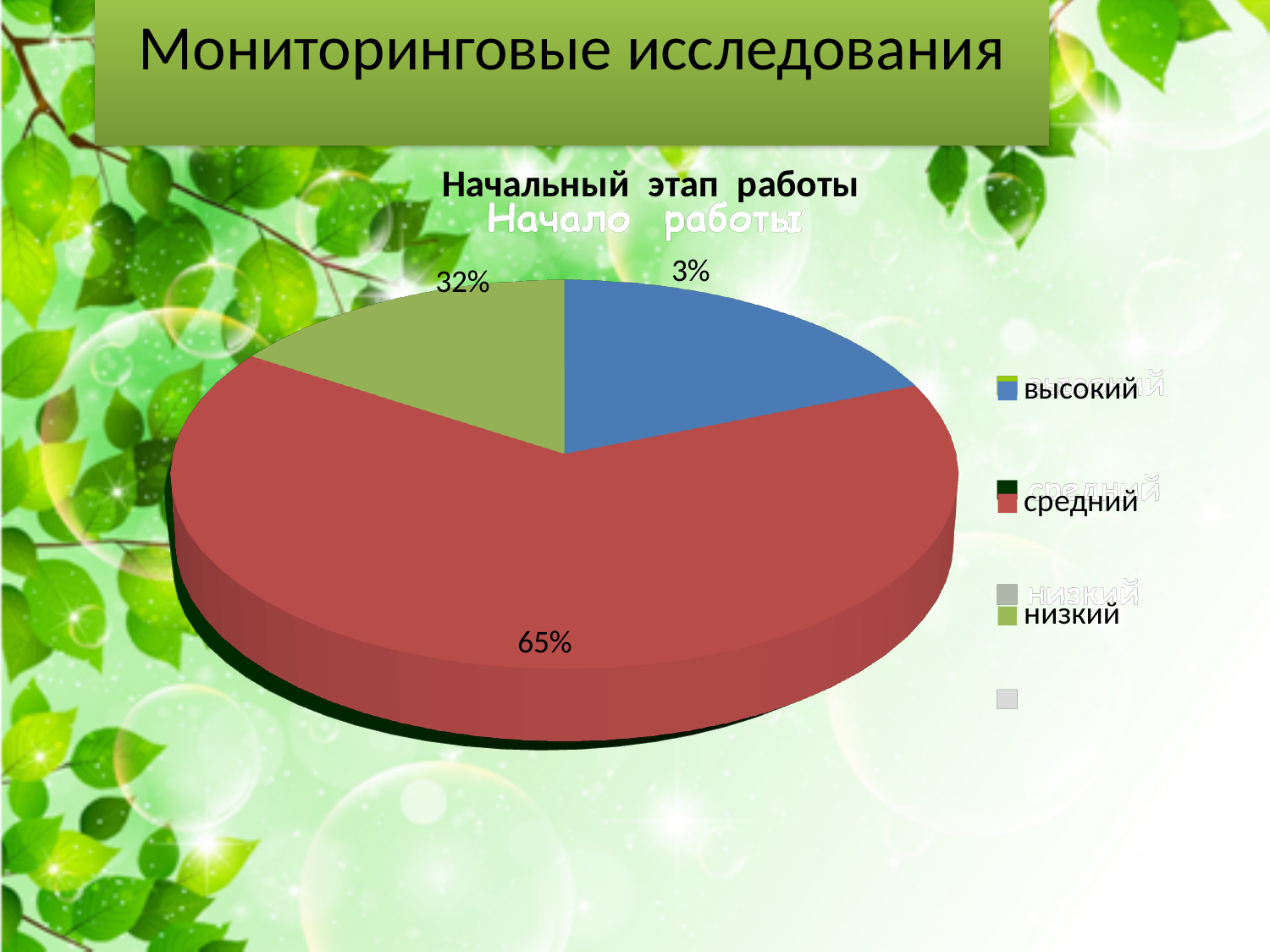
What is the difference between the 'средний' and 'низкий' shares? 33% What percentage does the 'средний' slice represent? 65% What kind of chart is shown on the slide? pie chart Which category has the smallest share of the pie? высокий What is the difference between the 'низкий' and 'высокий' shares? 29% What percentage does the 'высокий' slice represent? 3% What colour is the 'средний' slice? red What percentage does the 'низкий' slice represent? 32% Which category has the largest share of the pie? средний Which is larger, the 'низкий' share or the 'высокий' share? низкий How many slices does the pie chart have? 3 What is the title of the chart? Начальный этап работы